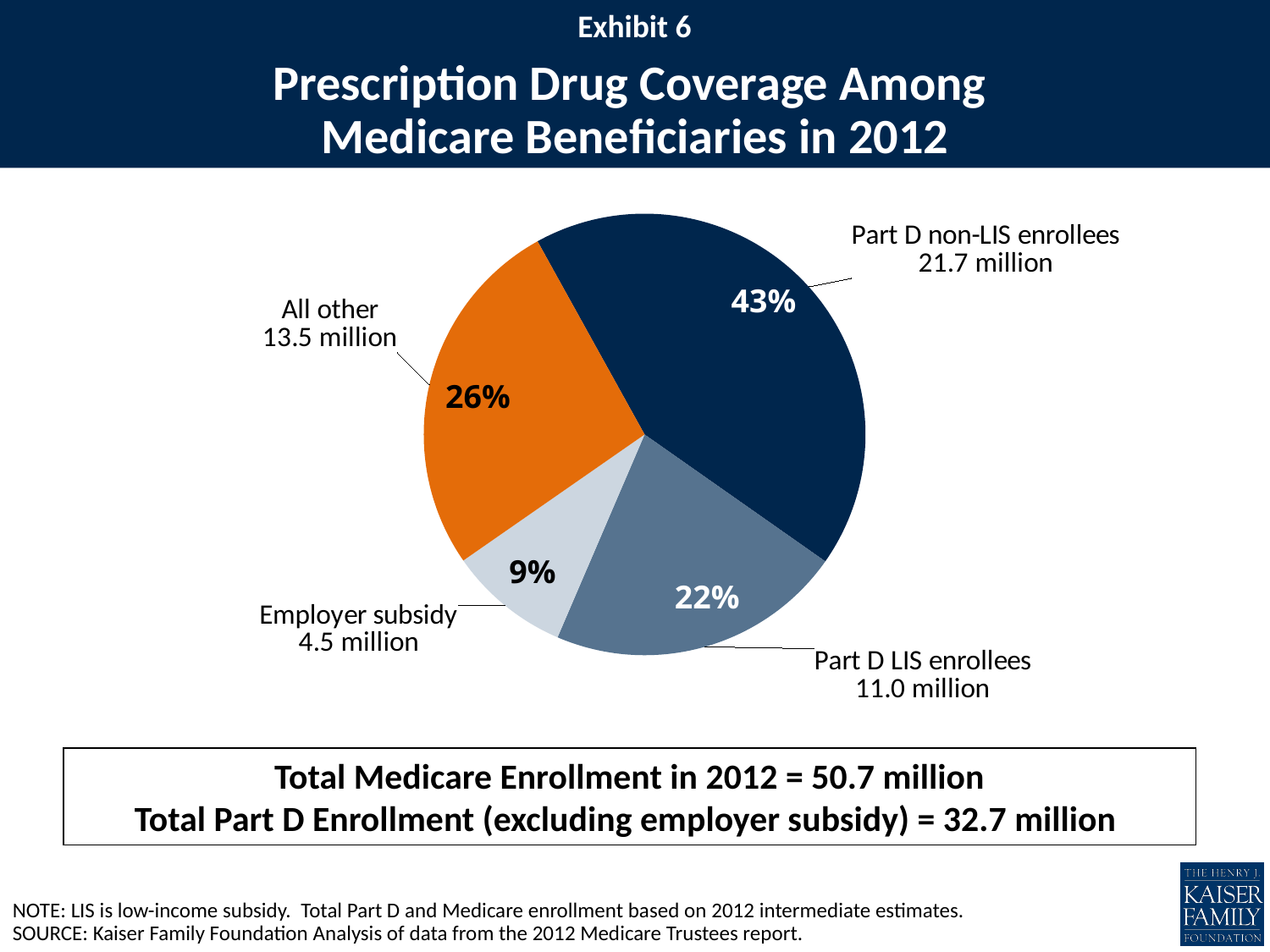
How many million beneficiaries are in the All other category? 13.5 million Which is larger, the All other slice or the Part D LIS enrollees slice? All other Which category has the largest slice of the pie? Part D non-LIS enrollees How many slices does the pie chart have? 4 What kind of chart is shown on the slide? pie chart What share of the pie does Employer subsidy represent? 9% What is the difference in percentage points between the Part D non-LIS enrollees slice and the Part D LIS enrollees slice? 21 percentage points How many million Part D LIS enrollees are shown? 11.0 million What share of the pie does the All other category represent? 26% What share of the pie do Part D non-LIS enrollees represent? 43% Which category has the smallest slice of the pie? Employer subsidy What is the title of the chart? Prescription Drug Coverage Among Medicare Beneficiaries in 2012